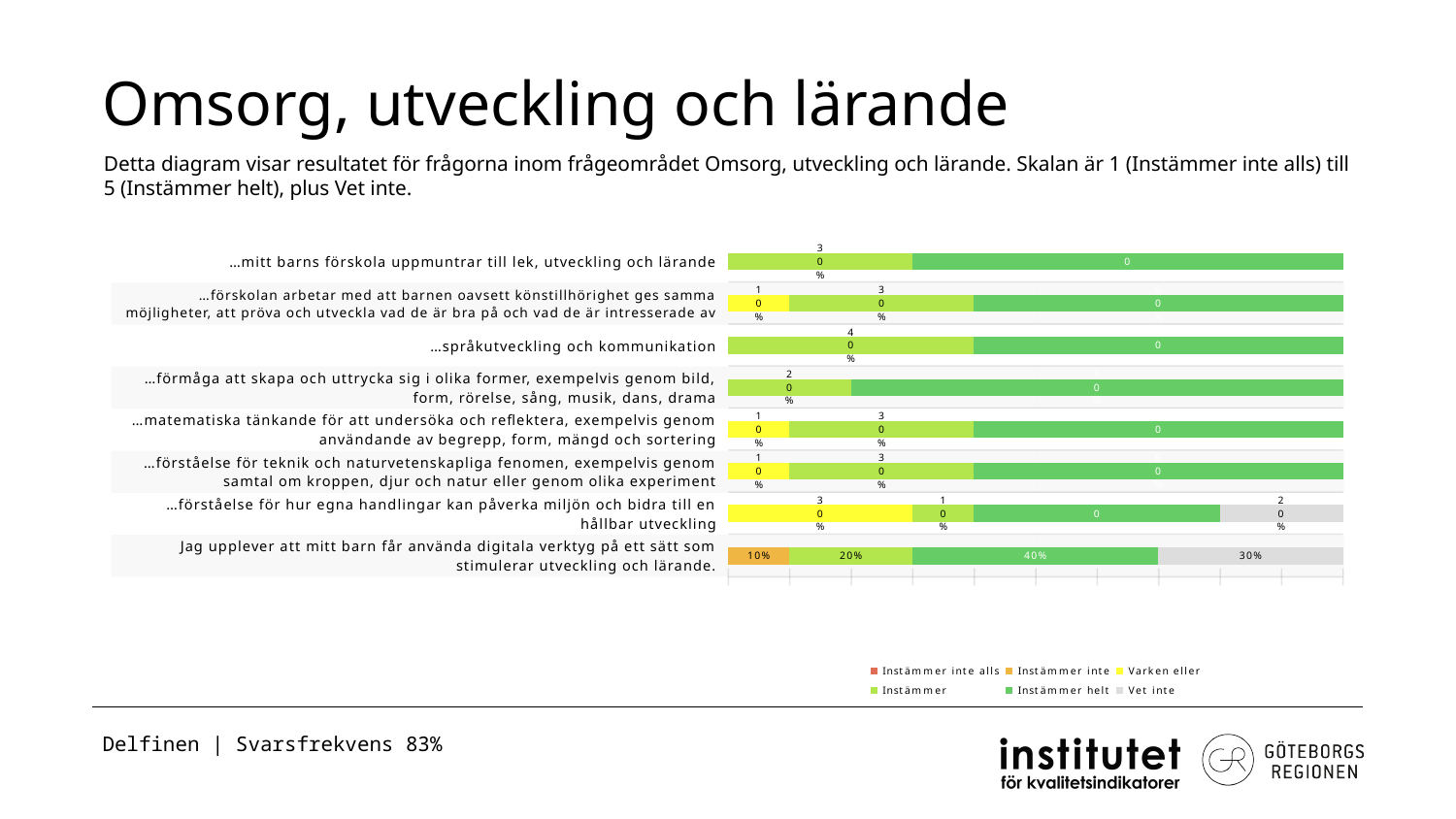
How many series does the legend list? 6 What kind of chart is shown on the slide? Stacked bar chart In the bar for the statement about digitala verktyg, which response category has the largest share? Instämmer helt Which legend entry is shown in grey? Vet inte For the statement 'Jag upplever att mitt barn får använda digitala verktyg på ett sätt som stimulerar utveckling och lärande', what share answered 'Vet inte'? 30% In the bar for the statement about digitala verktyg, which response category has the smallest share? Instämmer inte For the statement about digitala verktyg, what is the difference between the 'Instämmer helt' share and the 'Vet inte' share? 10 percentage points For the statement about digitala verktyg, what share answered 'Instämmer'? 20% For the statement about digitala verktyg, what share answered 'Instämmer helt'? 40% How many question statements (categories) are plotted in the chart? 8 For the statement about digitala verktyg, which is larger: the 'Instämmer' share or the 'Vet inte' share? Vet inte For the statement about digitala verktyg, what share answered 'Instämmer inte'? 10%